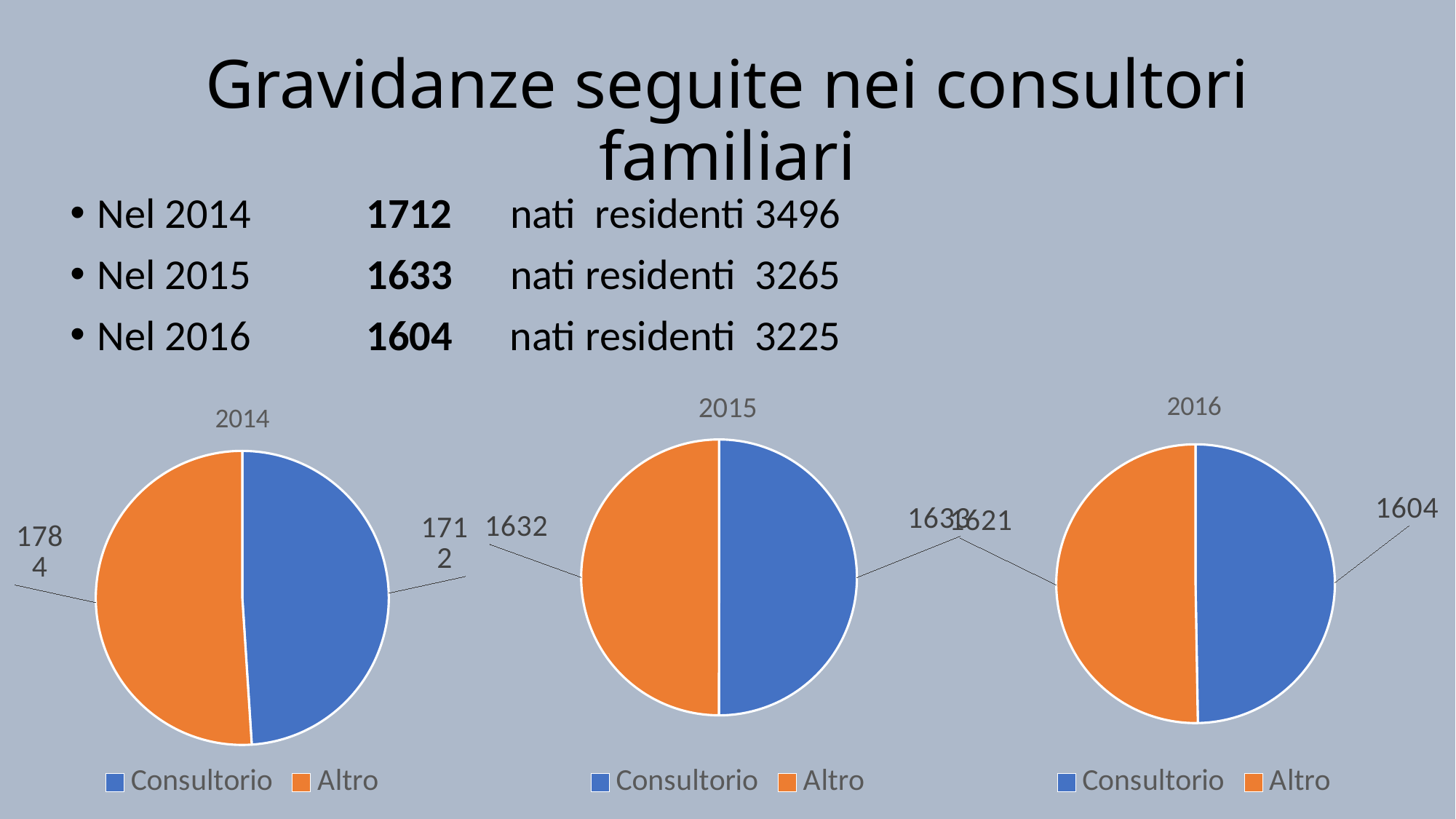
How many entries does the legend of the 2016 pie chart list? 2 What kind of chart is used for 2016? Pie chart How many slices does the 2015 pie chart have? 2 In the 2014 pie chart, what is the difference between the Altro value and the Consultorio value? 72 In the 2014 pie chart, what is the value for Consultorio? 1712 In the 2014 pie chart, what is the value for Altro? 1784 In the 2014 pie chart, what is the total of the two slices? 3496 In the 2014 pie chart, which slice is larger, Consultorio or Altro? Altro In the 2015 pie chart, what is the value for Altro? 1632 In the 2014 pie chart, which colour represents Consultorio? Blue In the 2016 pie chart, what is the value for Consultorio? 1604 What is the title of the leftmost pie chart? 2014